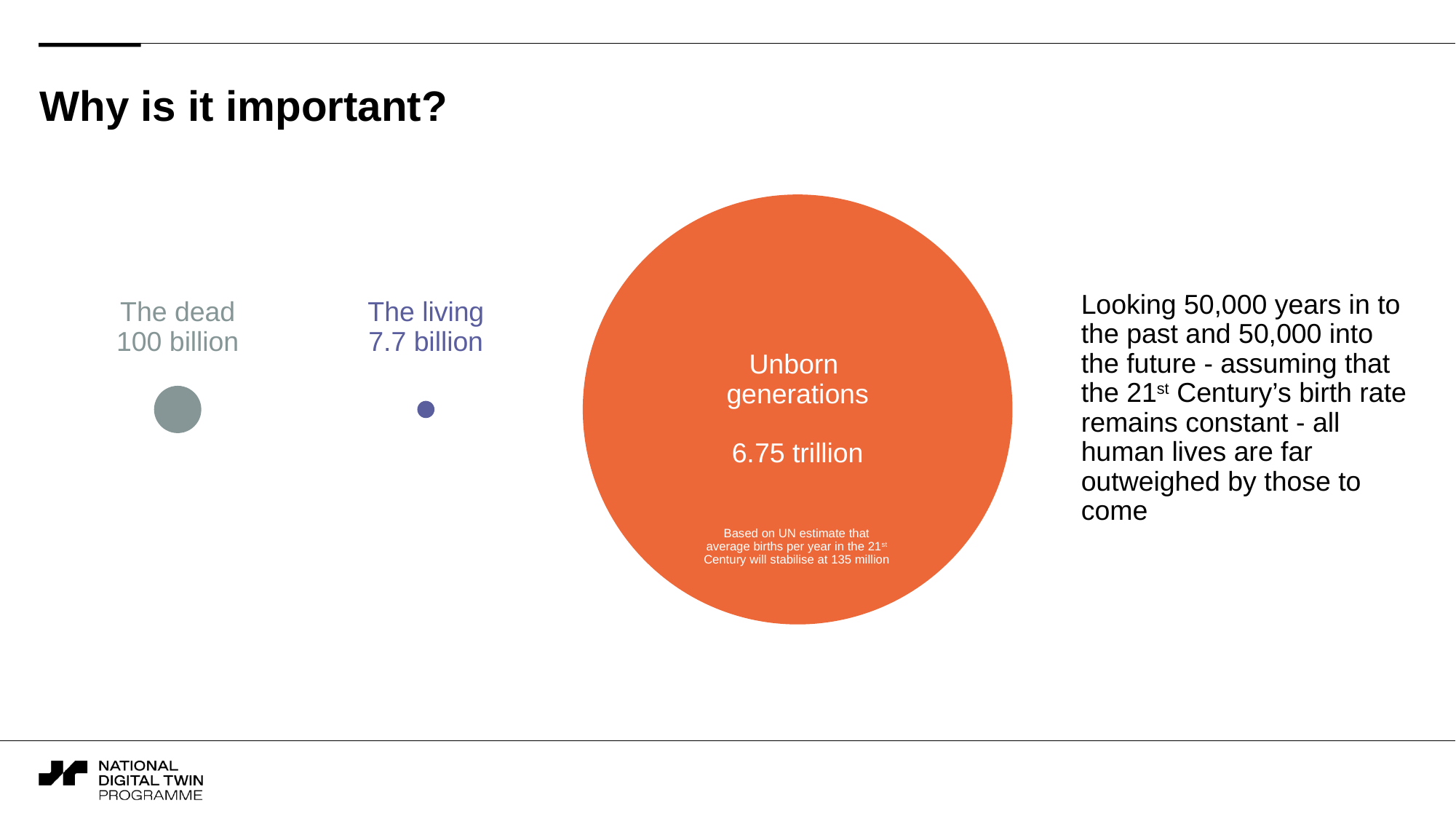
Which category has the largest value? Unborn generations What kind of chart is shown on the slide? Bubble chart What value is shown for Unborn generations? 6.75 trillion What value is shown for The dead? 100 billion Which is larger, the value for The dead or the value for The living? The dead According to the note inside the largest circle, at what level will average births per year in the 21st Century stabilise? 135 million How many categories are shown in the chart? 3 Which category has the smallest value? The living What is the difference between the value for The dead and the value for The living? 92.3 billion What value is shown for The living? 7.7 billion What colour is the circle for Unborn generations? Orange